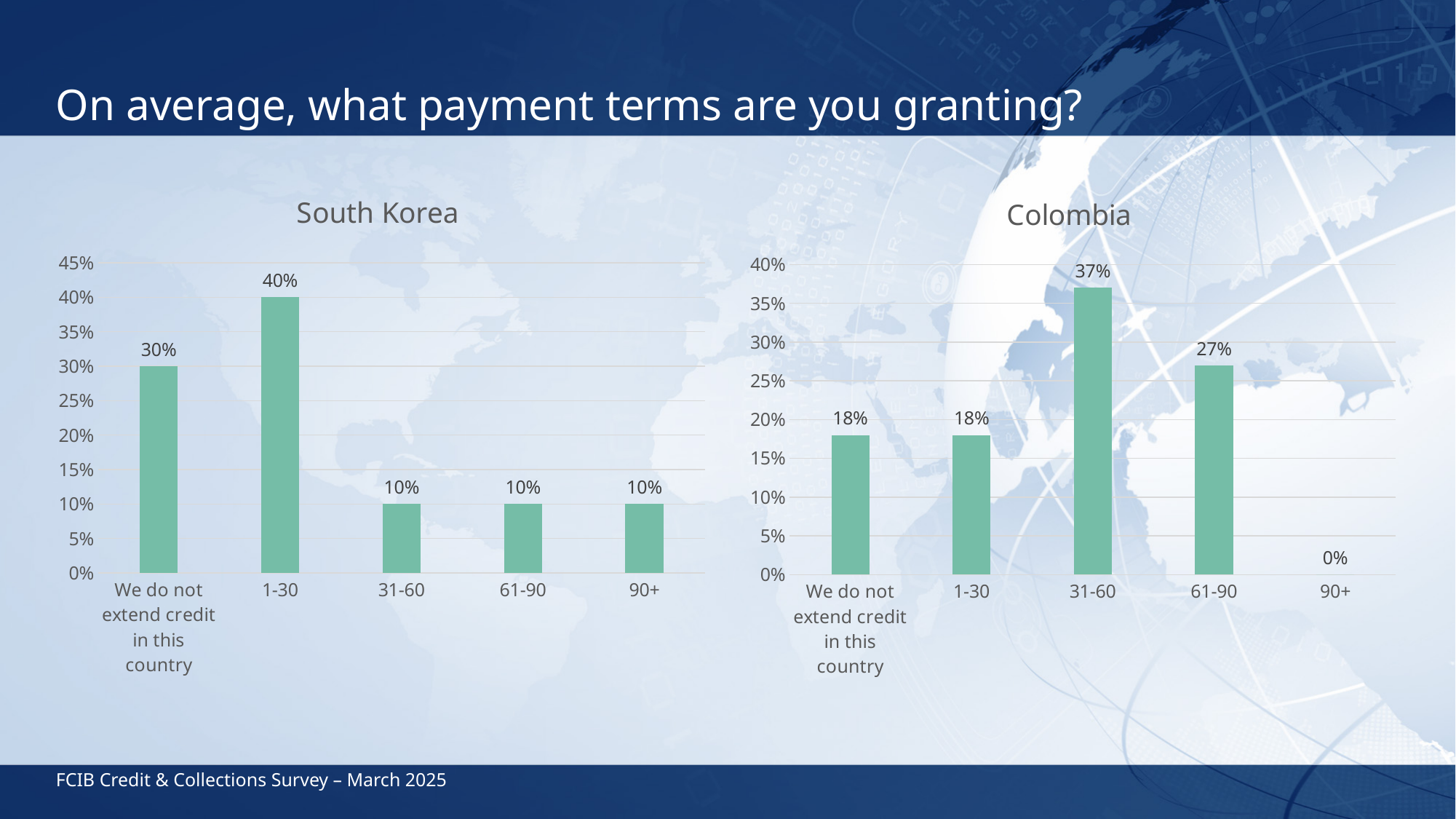
In the South Korea chart, what is the difference between the values for 1-30 and 'We do not extend credit in this country'? 10% What kind of chart is the South Korea chart? bar chart In the Colombia chart, what is the value for 90+? 0% In the South Korea chart, is the value for 'We do not extend credit in this country' greater or less than 25%? greater In the Colombia chart, what is the value for 31-60? 37% In the Colombia chart, which category has the lowest value? 90+ What is the title of the chart on the right side of the slide? Colombia In the Colombia chart, which is larger, the value for 61-90 or the value for 1-30? 61-90 In the South Korea chart, which category has the highest value? 1-30 In the South Korea chart, what is the value for 1-30? 40% How many categories are shown in the Colombia chart? 5 In the Colombia chart, what is the difference between the values for 31-60 and 61-90? 10%